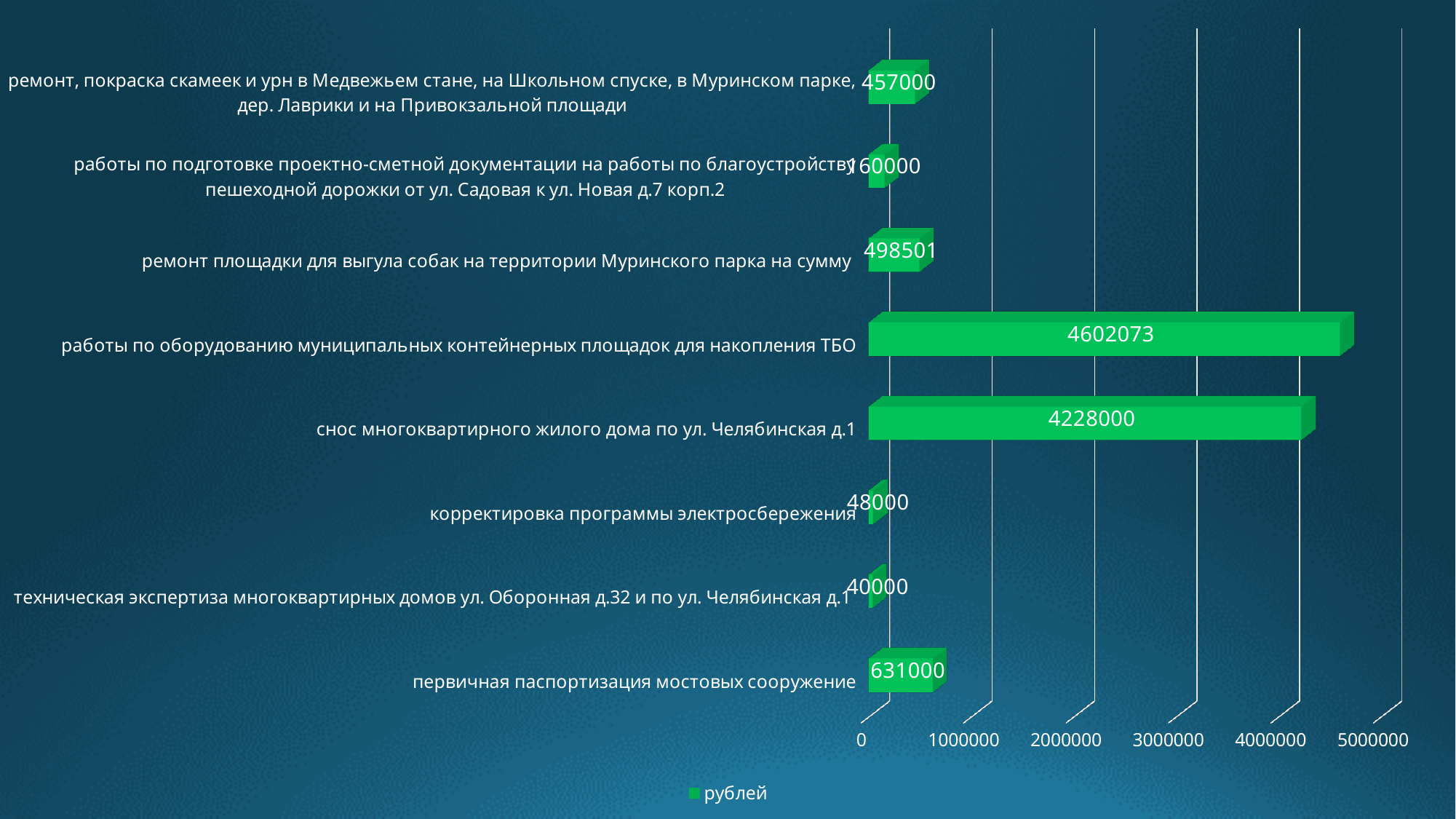
What is the value for 'работы по оборудованию муниципальных контейнерных площадок для накопления ТБО'? 4602073 How many categories are plotted in the chart? 8 What is the difference between the values for 'работы по оборудованию муниципальных контейнерных площадок для накопления ТБО' and 'снос многоквартирного жилого дома по ул. Челябинская д.1'? 374073 Which category has the lowest value? техническая экспертиза многоквартирных домов ул. Оборонная д.32 и по ул. Челябинская д.1 What is the value for 'снос многоквартирного жилого дома по ул. Челябинская д.1'? 4228000 Which is larger: the value for 'первичная паспортизация мостовых сооружение' or the value for 'корректировка программы электросбережения'? первичная паспортизация мостовых сооружение What type of chart is shown on the slide? bar chart How many series does the legend list? 1 Which category has the highest value? работы по оборудованию муниципальных контейнерных площадок для накопления ТБО What is the name of the series shown in the legend? рублей What is the value for 'ремонт площадки для выгула собак на территории Муринского парка на сумму'? 498501 What is the value for 'первичная паспортизация мостовых сооружение'? 631000